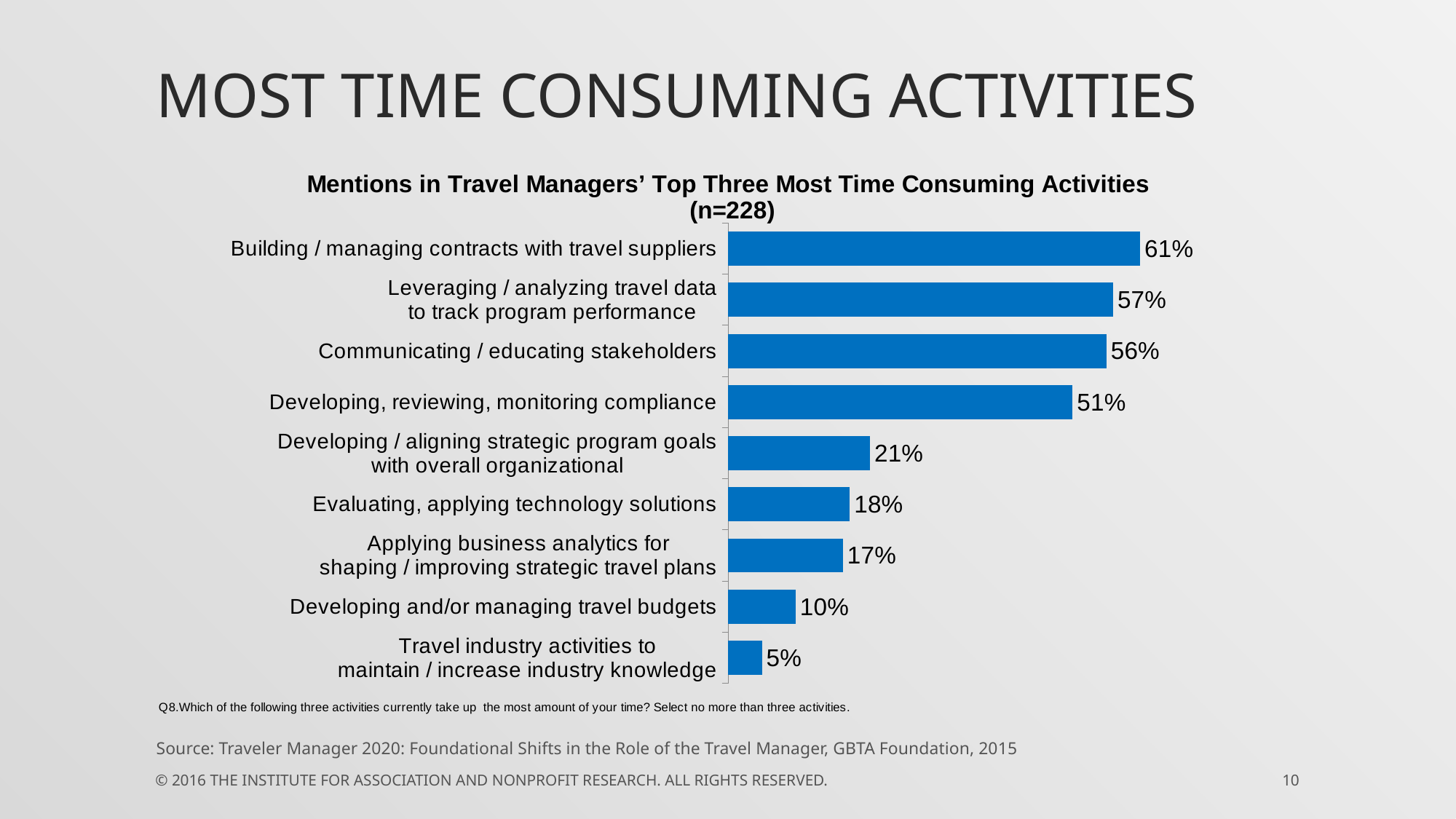
What sample size (n) is stated in the chart title? n=228 Which activity has the lowest percentage of mentions? Travel industry activities to maintain / increase industry knowledge What is the difference in percentage points between 'Building / managing contracts with travel suppliers' and 'Developing, reviewing, monitoring compliance'? 10 percentage points Which activity has the highest percentage of mentions? Building / managing contracts with travel suppliers Which has a higher value: 'Leveraging / analyzing travel data to track program performance' or 'Developing, reviewing, monitoring compliance'? Leveraging / analyzing travel data to track program performance What is the value shown for 'Communicating / educating stakeholders'? 56% What type of chart is shown on the slide? Bar chart How many activities are shown in the chart? 9 What is the value shown for 'Developing and/or managing travel budgets'? 10% What is the difference between 'Developing / aligning strategic program goals with overall organizational' and 'Evaluating, applying technology solutions'? 3 percentage points What percentage of travel managers mentioned 'Building / managing contracts with travel suppliers' among their top three most time consuming activities? 61% Which has a lower value: 'Applying business analytics for shaping / improving strategic travel plans' or 'Developing and/or managing travel budgets'? Developing and/or managing travel budgets